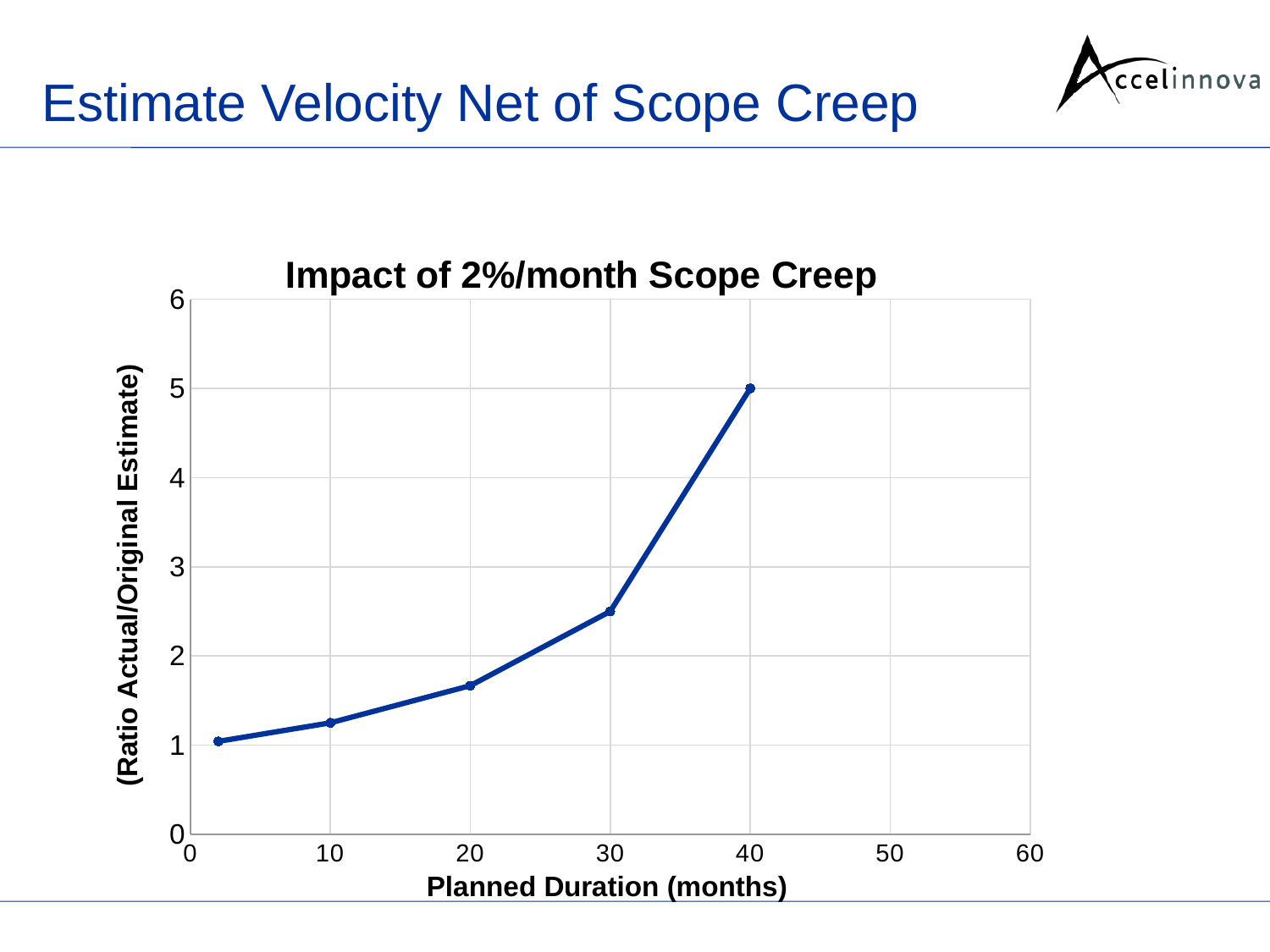
What kind of chart is shown on the slide? line chart What is the title of the chart? Impact of 2%/month Scope Creep Is the ratio at a planned duration of 10 months greater or less than 2? less Is the ratio at a planned duration of 30 months greater or less than 2? greater Does the ratio rise or fall as planned duration increases? rises What is the label of the x axis? Planned Duration (months) How many data points are plotted on the line? 5 At which planned duration is the ratio highest? 40 Which has the larger ratio: a planned duration of 30 months or 20 months? 30 months Is the ratio at a planned duration of 20 months greater or less than 2? less What is the ratio of actual to original estimate at a planned duration of 40 months? 5